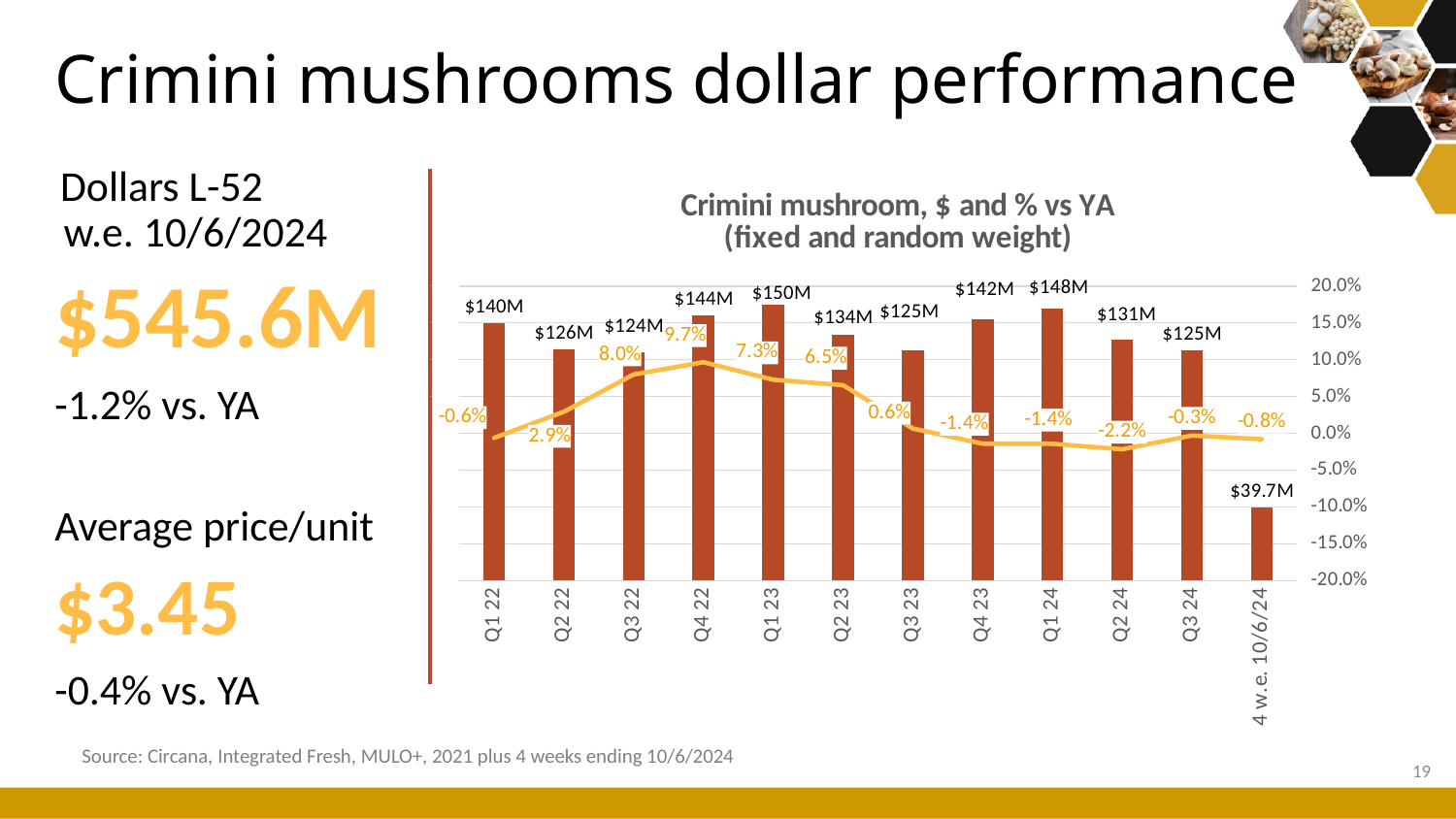
What is the title of the chart? Crimini mushroom, $ and % vs YA (fixed and random weight) What is the dollar value shown for Q1 23? $150M What kind of chart is shown on the slide? Combination bar and line chart What is the difference in dollar value between Q1 23 and Q1 22? $10M What is the % vs YA value shown for Q2 24? -2.2% Which period has the lowest % vs YA value on the line? Q2 24 What is the dollar value shown for the 4 w.e. 10/6/24 period? $39.7M What is the % vs YA value shown for Q4 22? 9.7% Which period has the highest % vs YA value on the line? Q4 22 Which is larger, the dollar value for Q4 22 or for Q4 23? Q4 22 Which period has the highest dollar value bar? Q1 23 How many periods are shown on the x axis of the chart? 12